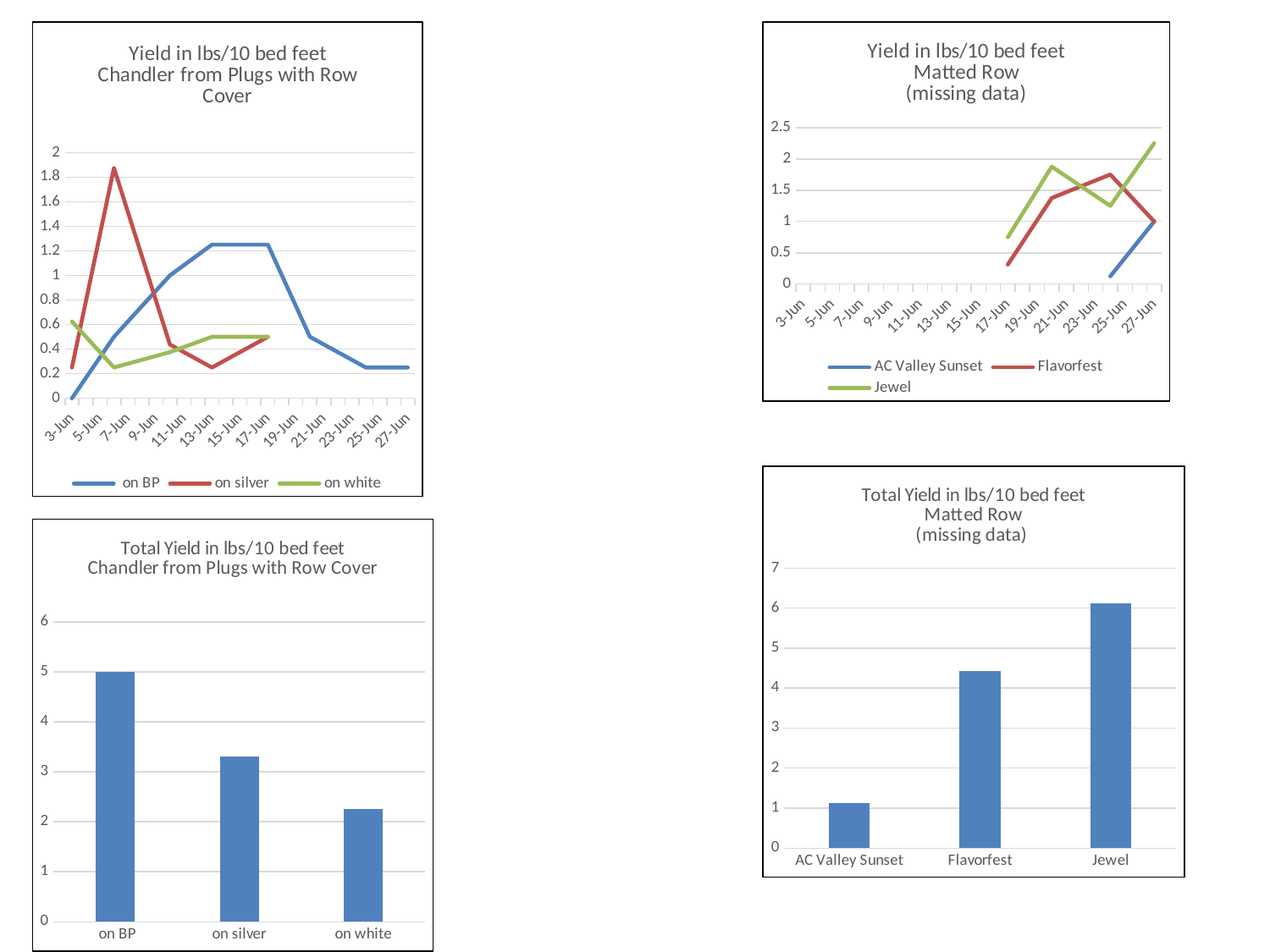
In the bottom-left chart 'Total Yield in lbs/10 bed feet Chandler from Plugs with Row Cover', which is larger, the value for on silver or the value for on white? on silver In the bottom-left chart 'Total Yield in lbs/10 bed feet Chandler from Plugs with Row Cover', which category has the highest total yield? on BP In the bottom-left chart 'Total Yield in lbs/10 bed feet Chandler from Plugs with Row Cover', which category has the lowest total yield? on white How many series does the legend of the top-right chart 'Yield in lbs/10 bed feet Matted Row (missing data)' list? 3 What kind of chart is the top-left chart titled 'Yield in lbs/10 bed feet Chandler from Plugs with Row Cover'? line chart In the bottom-right chart 'Total Yield in lbs/10 bed feet Matted Row (missing data)', which variety has the lowest total yield? AC Valley Sunset In the bottom-right chart 'Total Yield in lbs/10 bed feet Matted Row (missing data)', which variety has the highest total yield? Jewel In the top-left chart 'Yield in lbs/10 bed feet Chandler from Plugs with Row Cover', does the 'on BP' line rise or fall from 17-Jun to 25-Jun? fall In the bottom-right chart 'Total Yield in lbs/10 bed feet Matted Row (missing data)', is the value for Flavorfest greater or less than 4? greater How many bars are shown in the bottom-right chart 'Total Yield in lbs/10 bed feet Matted Row (missing data)'? 3 In the bottom-left chart 'Total Yield in lbs/10 bed feet Chandler from Plugs with Row Cover', is the value for on white greater or less than 3? less What kind of chart is the bottom-left chart titled 'Total Yield in lbs/10 bed feet Chandler from Plugs with Row Cover'? bar chart